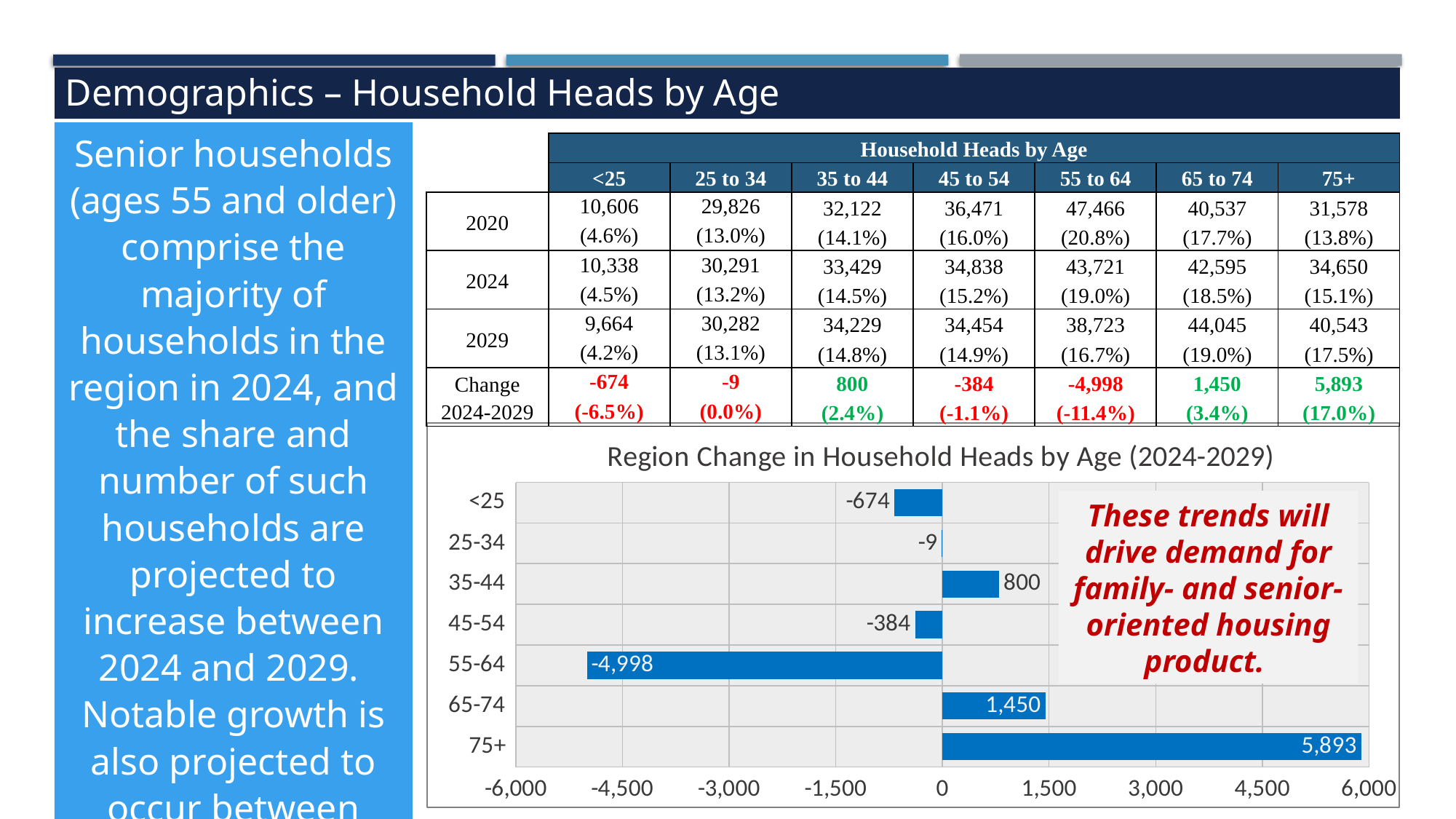
What is the difference between the values for 75+ and 65-74 in the chart? 4,443 Is the value for 55-64 in the chart greater or less than -4,500? less Which has the larger value in the chart, 35-44 or 65-74? 65-74 What is the value for the 75+ age group in the chart? 5,893 How many age groups are shown in the chart? 7 What is the value for the <25 age group in the chart? -674 What is the value for the 35-44 age group in the chart? 800 Which age group has the lowest value in the chart? 55-64 What is the value for the 55-64 age group in the chart? -4,998 Which age group has the highest value in the chart? 75+ What kind of chart is shown on the slide? bar chart What is the title of the chart on the slide? Region Change in Household Heads by Age (2024-2029)